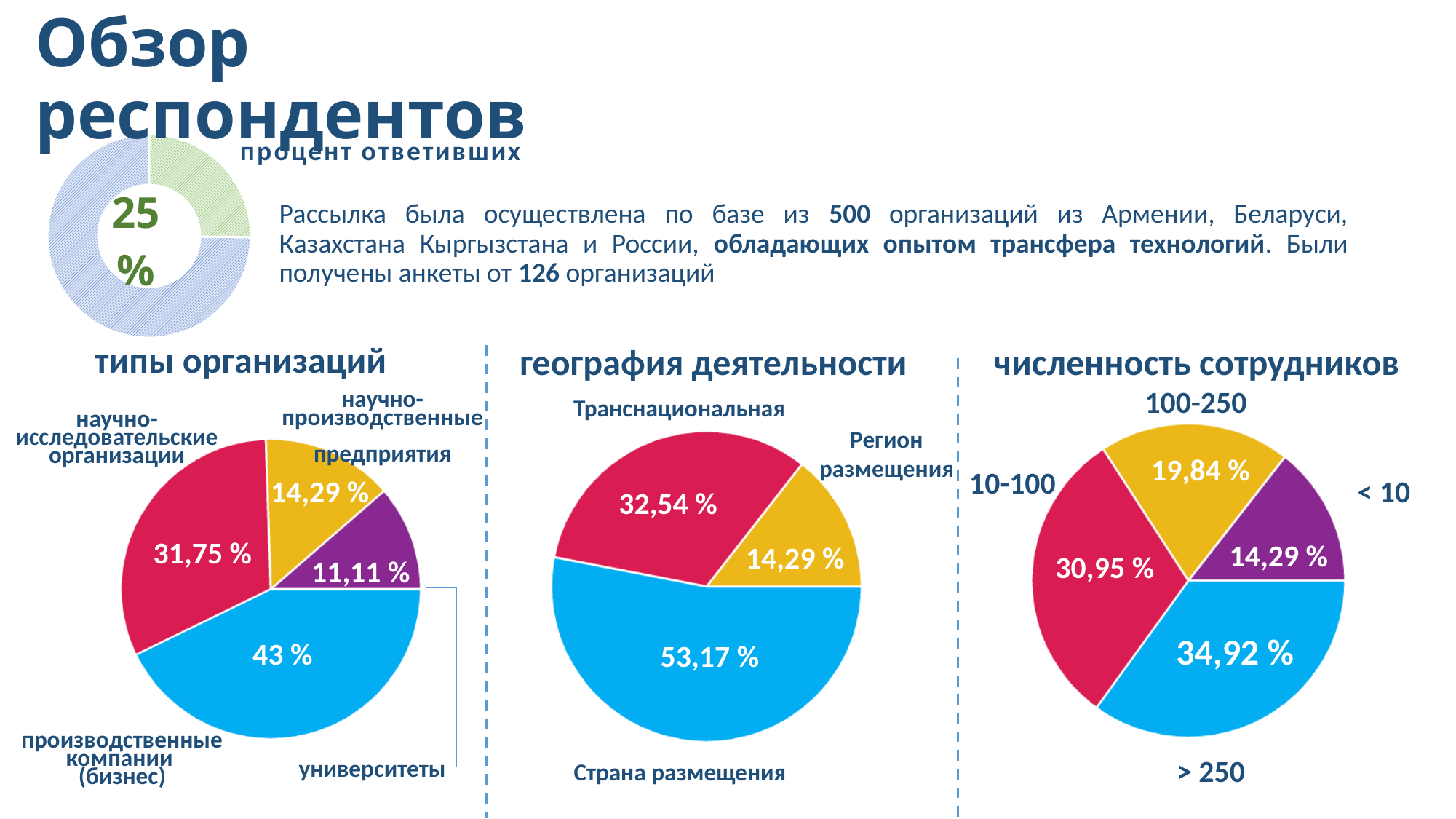
In the chart 'численность сотрудников', which category has the largest slice? > 250 In the chart 'типы организаций', how many slices does the pie have? 4 In the chart 'типы организаций', what share is shown for производственные компании (бизнес)? 43 % In the chart 'география деятельности', what share is shown for Страна размещения? 53,17 % What kind of chart is used for 'численность сотрудников'? pie chart In the chart 'география деятельности', what is the difference between the shares for Транснациональная and Регион размещения? 18,25 % In the chart 'география деятельности', which is larger: Транснациональная or Регион размещения? Транснациональная In the chart 'типы организаций', which category has the smallest slice? университеты In the chart 'типы организаций', which category has the largest slice? производственные компании (бизнес) In the chart 'численность сотрудников', what share is shown for 10-100? 30,95 % What percentage is shown in the donut chart labelled 'процент ответивших' at the top left of the slide? 25 % In the chart 'типы организаций', what share is shown for университеты? 11,11 %